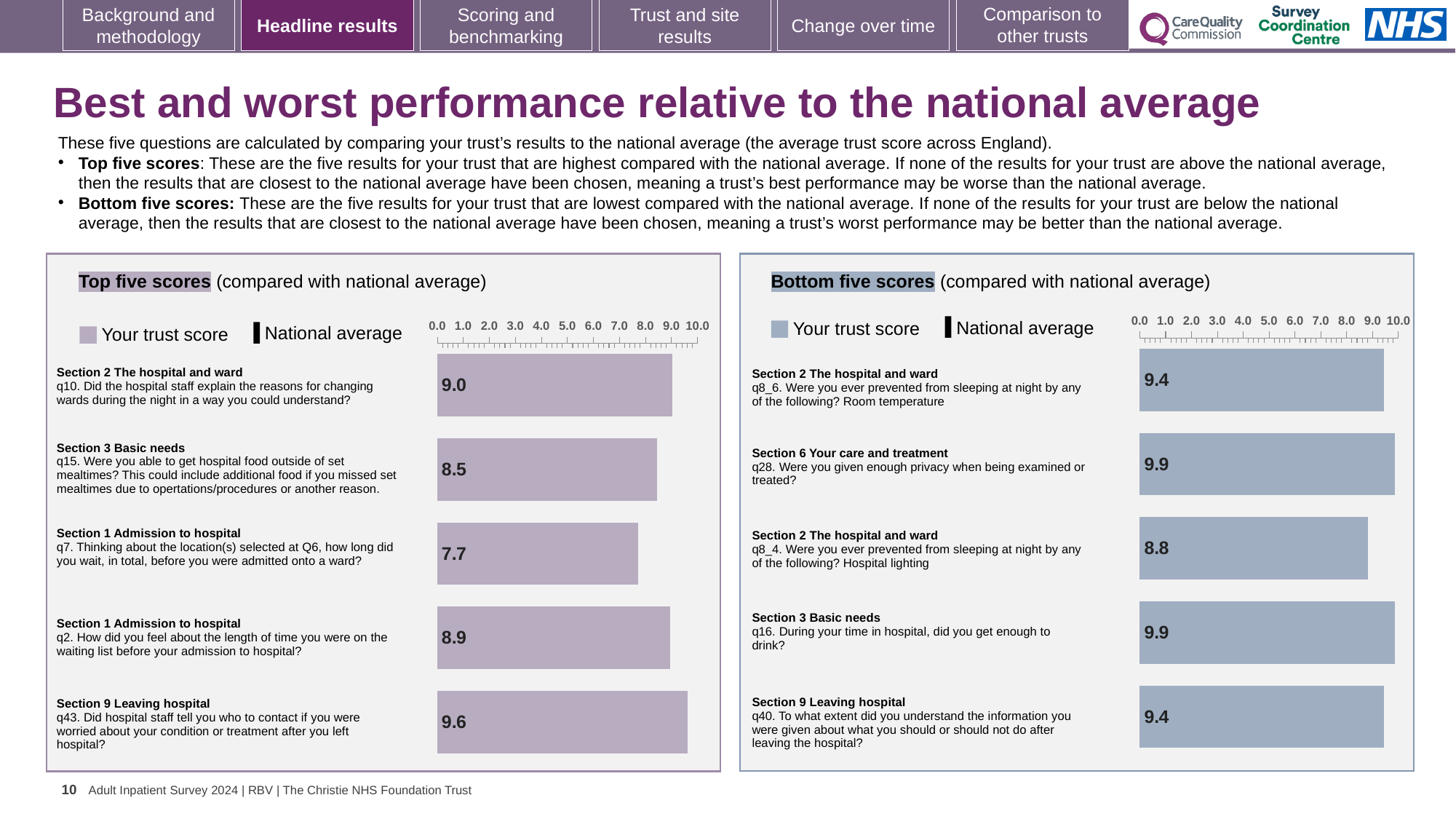
What type of chart is used in the Top five scores panel? Bar chart In the Bottom five scores chart, which question has the lowest trust score? q8_4 (Section 2 The hospital and ward) In the Top five scores chart, which question has the highest trust score? q43 (Section 9 Leaving hospital) In the Bottom five scores chart, which is larger: the trust score for q28 or for q8_6? q28 In the Top five scores chart, which question has the lowest trust score? q7 (Section 1 Admission to hospital) In the Top five scores chart, what is the difference between the trust scores for q43 and q7? 1.9 In the Top five scores chart, what is the trust score for q10 (explaining reasons for changing wards during the night)? 9.0 In the Bottom five scores chart, what is the difference between the trust scores for q16 and q8_4? 1.1 In the Top five scores chart, what is the trust score for q15 (getting hospital food outside of set mealtimes)? 8.5 In the Top five scores chart, how many questions are plotted? 5 In the Bottom five scores chart, what is the trust score for q40 (understanding information given about what to do after leaving hospital)? 9.4 In the Bottom five scores chart, what is the trust score for q8_4 (prevented from sleeping by hospital lighting)? 8.8